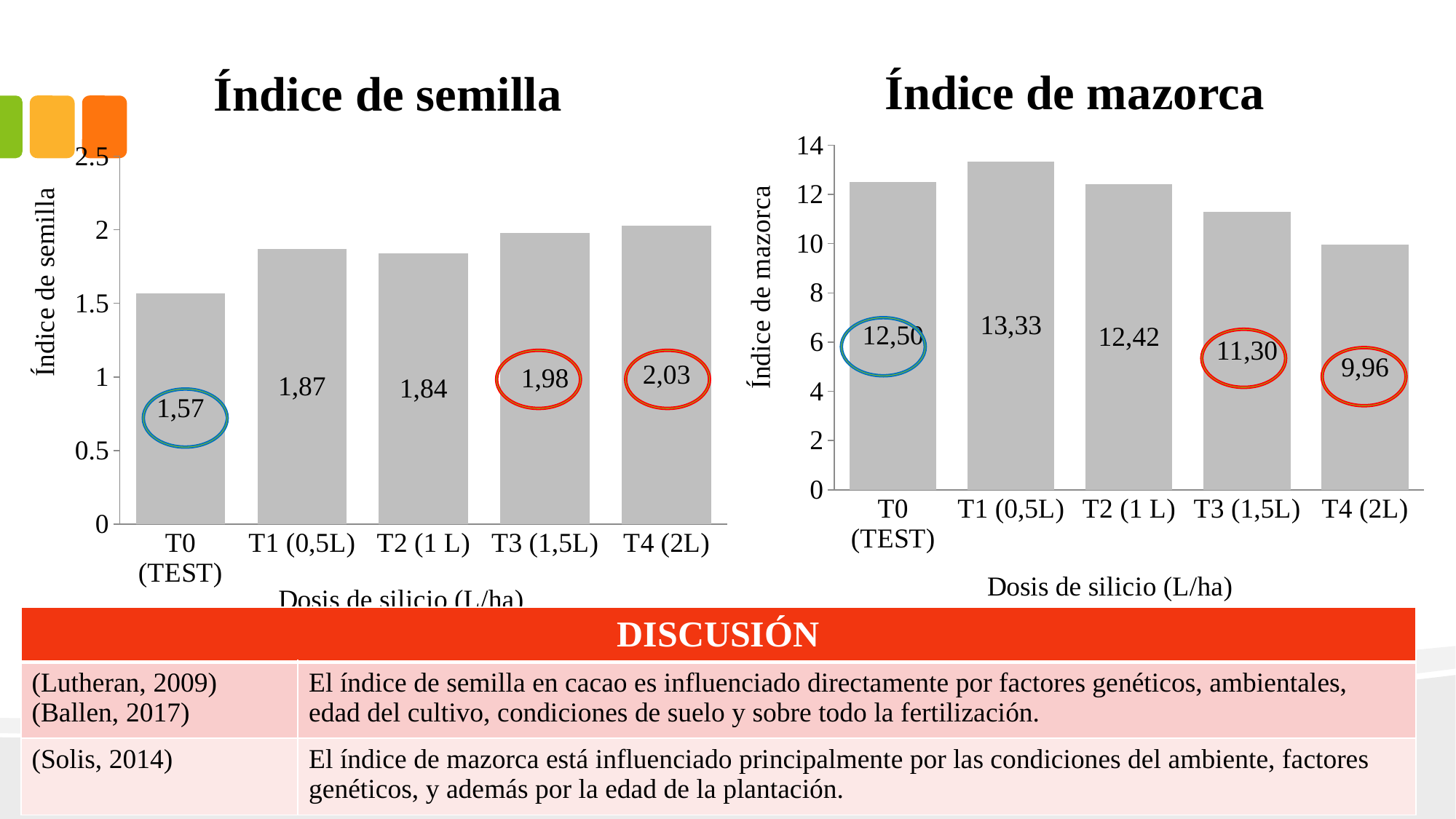
In the 'Índice de semilla' chart, which category has the highest value? T4 (2L) In the 'Índice de mazorca' chart, what is the value for T1 (0,5L)? 13,33 In the 'Índice de semilla' chart, what is the value for T0 (TEST)? 1,57 In the 'Índice de mazorca' chart, which category has the lowest value? T4 (2L) In the 'Índice de mazorca' chart, is the value for T3 (1,5L) larger or smaller than the value for T2 (1 L)? smaller In the 'Índice de mazorca' chart, what is the difference between the values for T1 (0,5L) and T4 (2L)? 3,37 In the 'Índice de semilla' chart, how many categories are shown on the x axis? 5 In the 'Índice de mazorca' chart, which category has the highest value? T1 (0,5L) In the 'Índice de semilla' chart, which category has the lowest value? T0 (TEST) In the 'Índice de semilla' chart, what is the difference between the values for T4 (2L) and T0 (TEST)? 0,46 What is the x-axis title of the 'Índice de mazorca' chart? Dosis de silicio (L/ha) What kind of chart is the 'Índice de mazorca' chart? bar chart